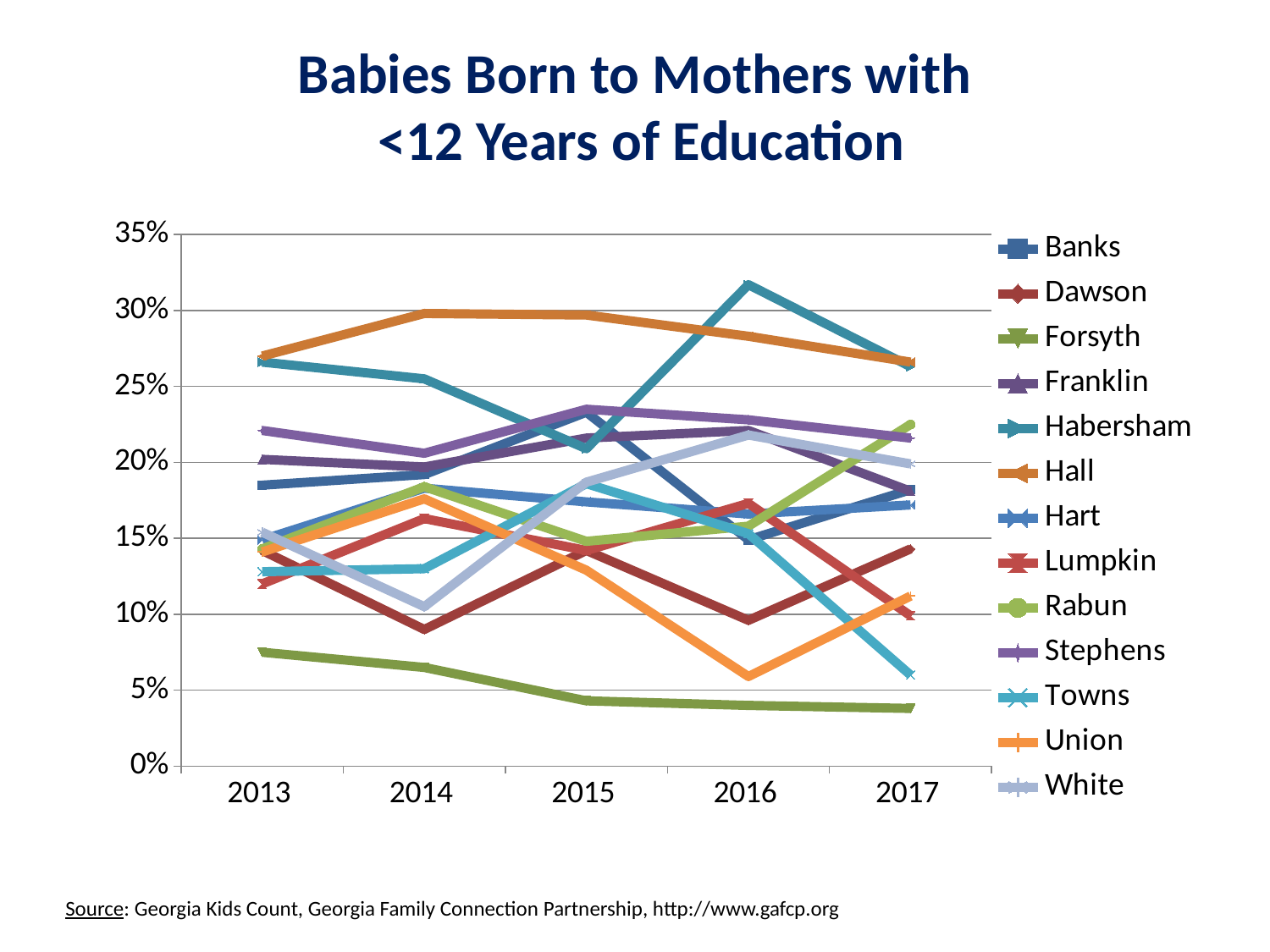
Is the value for Towns in 2017 greater or less than 10%? less How many series does the legend list? 13 Which county has the lowest value in every year shown? Forsyth In 2017, which is higher, Towns or Union? Union Is the value for Habersham in 2016 greater or less than 30%? greater What kind of chart is shown on the slide? line chart How many years are shown on the x axis? 5 Is the value for Forsyth in 2017 greater or less than 5%? less Which county has the highest value in 2016? Habersham Which county has the highest value in 2014? Hall What is the title of the chart? Babies Born to Mothers with <12 Years of Education Does the value for Forsyth rise or fall from 2013 to 2017? fall